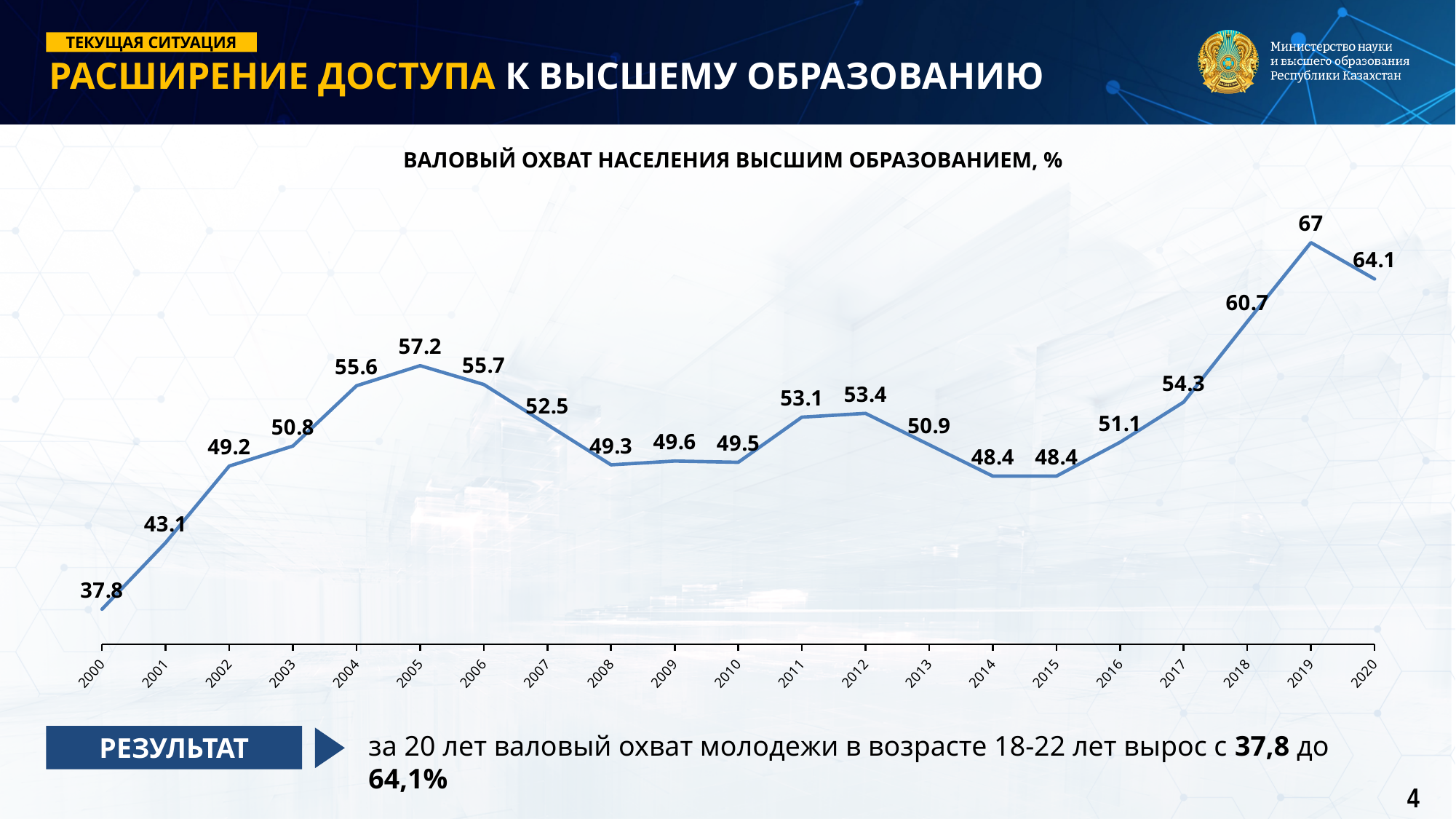
Which is larger, the value for 2005 or the value for 2012? 2005 Which year has the highest value? 2019 What is the value for 2020? 64.1 What is the value for 2019? 67 What is the value for 2005? 57.2 What type of chart is shown on the slide? line chart Which year has the lowest value? 2000 What is the difference between the values for 2020 and 2000? 26.3 What is the title of the chart? ВАЛОВЫЙ ОХВАТ НАСЕЛЕНИЯ ВЫСШИМ ОБРАЗОВАНИЕМ, % What is the value for 2000? 37.8 How many years are plotted on the x axis? 21 What is the difference between the values for 2019 and 2018? 6.3